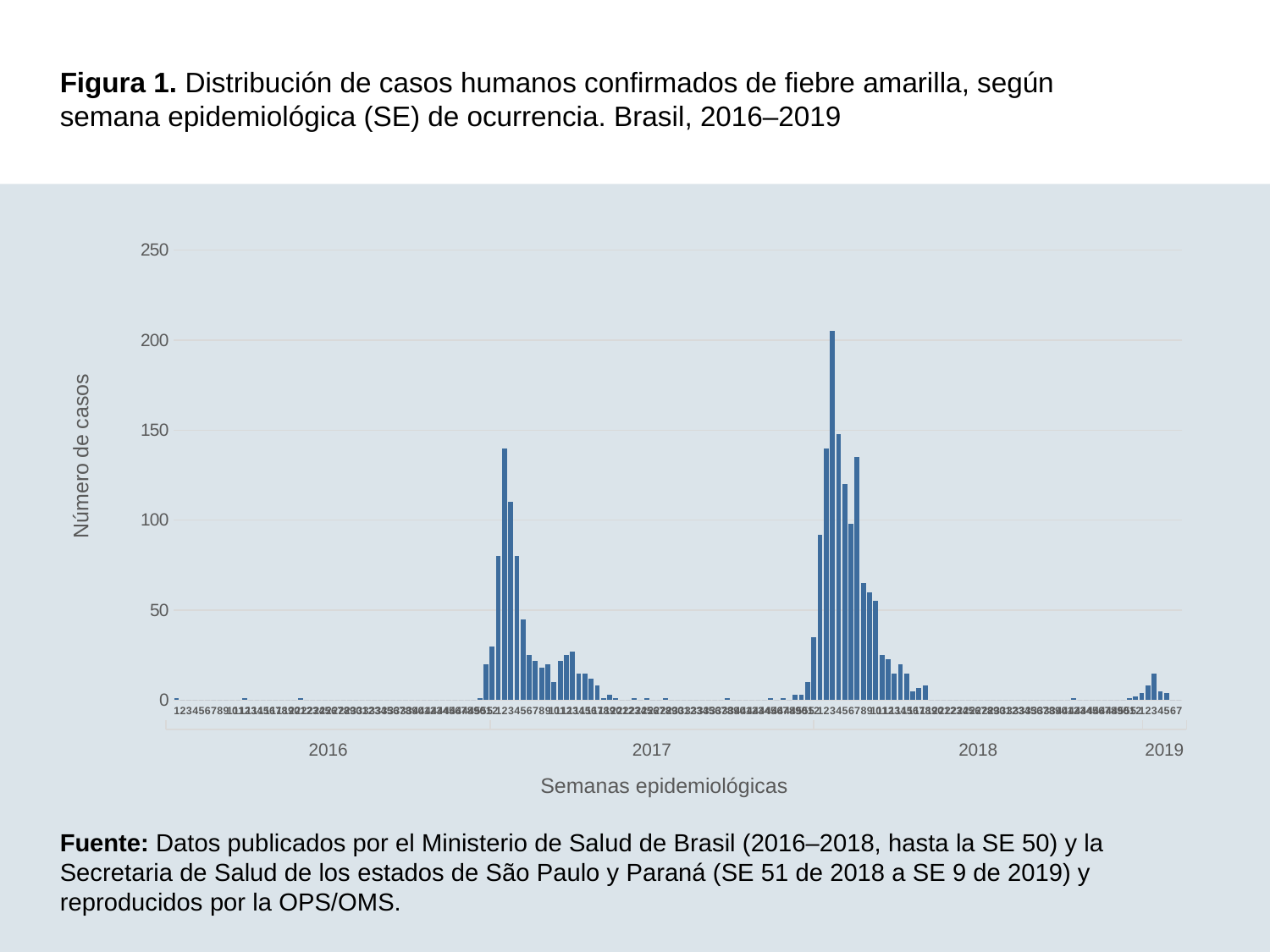
Which year has the higher peak of cases, 2016 or 2019? 2019 Is the tallest bar in 2016 greater or less than 50 cases? less Which year contains the tallest bar in the chart? 2018 What kind of chart is shown on the slide? bar chart Which year has the higher peak of cases, 2017 or 2018? 2018 Is the tallest bar in 2018 greater or less than 200 cases? greater What is the title of the y axis of the chart? Número de casos What is the highest value shown on the y axis of the chart? 250 Is the tallest bar in 2019 greater or less than 50 cases? less How many years are labelled along the x axis of the chart? 4